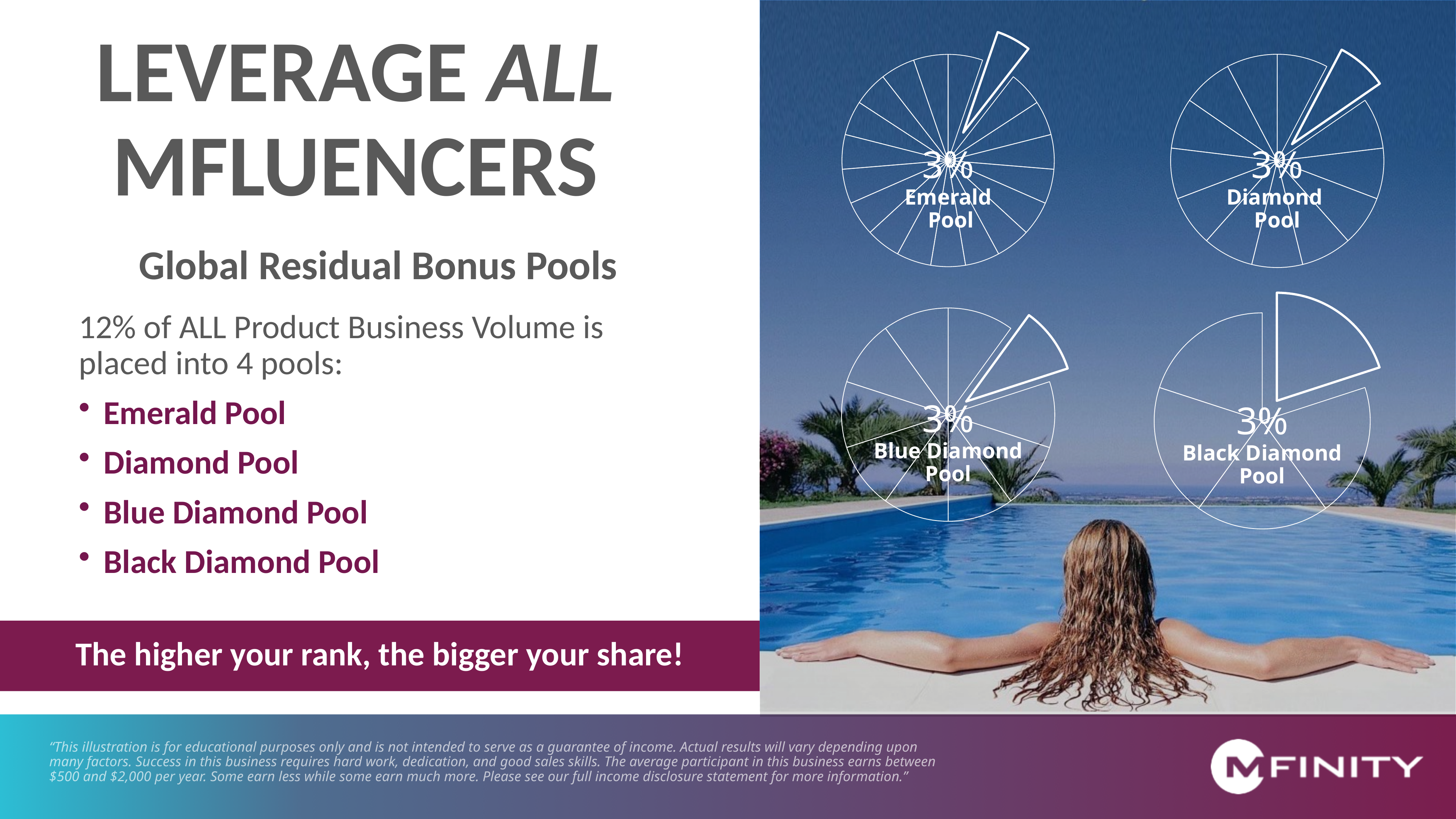
What kind of chart is used to show the Emerald Pool? pie chart Which chart has the larger highlighted slice, the Emerald Pool chart or the Black Diamond Pool chart? Black Diamond Pool How many pie charts are shown on the slide? 4 Which pool chart is in the top-right position on the slide? Diamond Pool What percentage is printed on the Black Diamond Pool chart? 3% What percentage is printed on the Blue Diamond Pool chart? 3% Of the four pool charts, which one has the largest single slice? Black Diamond Pool What is the total of the percentages printed on the four pool charts? 12% What percentage is printed on the Diamond Pool chart? 3% What percentage is printed on the Emerald Pool chart? 3% Which chart is divided into fewer slices, the Emerald Pool chart or the Black Diamond Pool chart? Black Diamond Pool Which pool chart is in the bottom-left position on the slide? Blue Diamond Pool